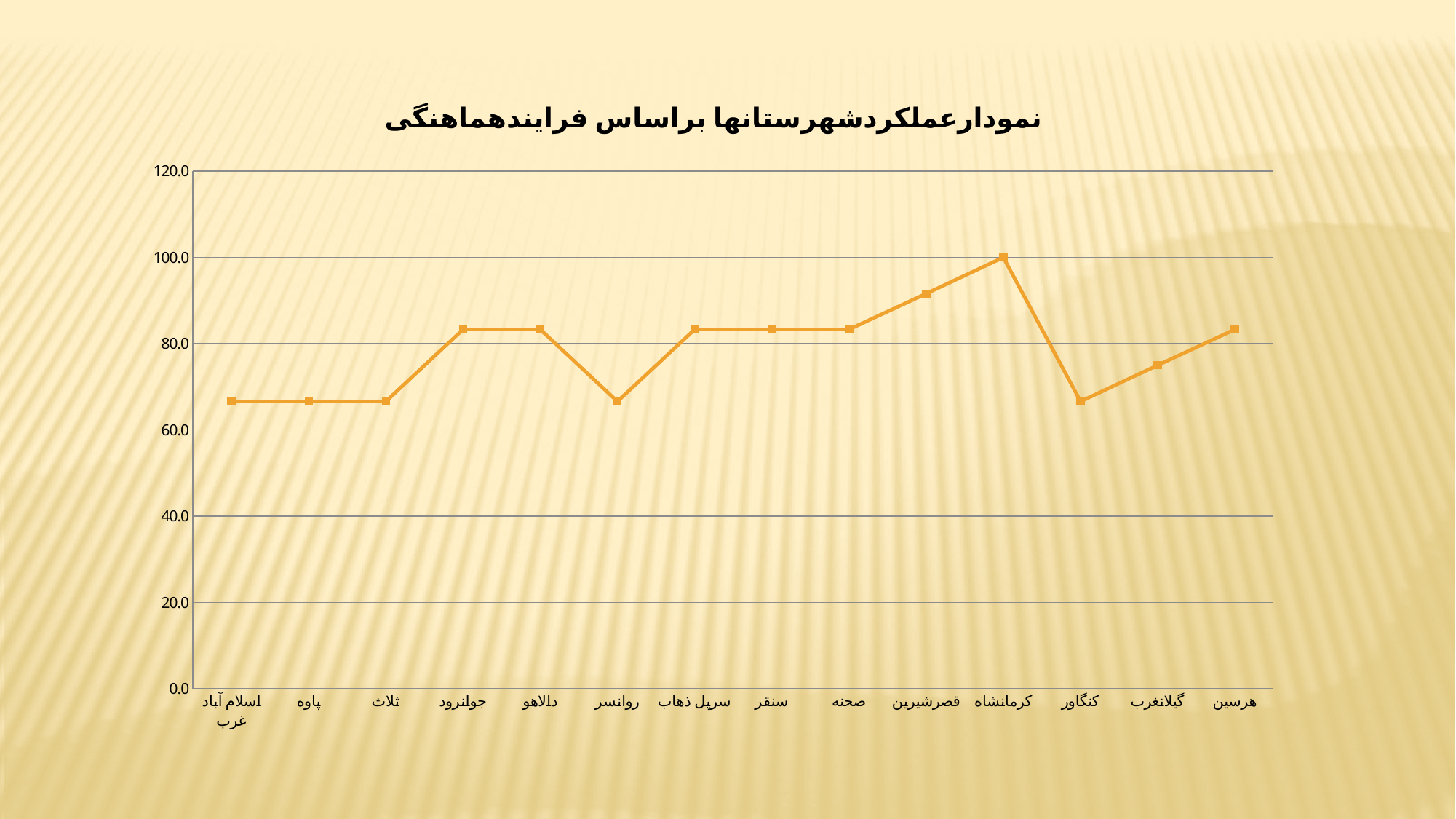
What is the value for کرمانشاه? 100.0 What kind of chart is shown on the slide? Line chart What is the title of the chart? نمودارعملکردشهرستانها براساس فرایندهماهنگی Which category has the highest value? کرمانشاه Is the value for جوانرود greater or less than 80.0? greater Is the value for اسلام آباد غرب greater or less than 80.0? less Is the value for قصرشیرین greater or less than 80.0? greater Which has the larger value, کرمانشاه or کنگاور? کرمانشاه Which has the larger value, قصرشیرین or گیلانغرب? قصرشیرین Does the line rise or fall from کرمانشاه to کنگاور? fall How many categories (cities) are plotted along the x axis? 14